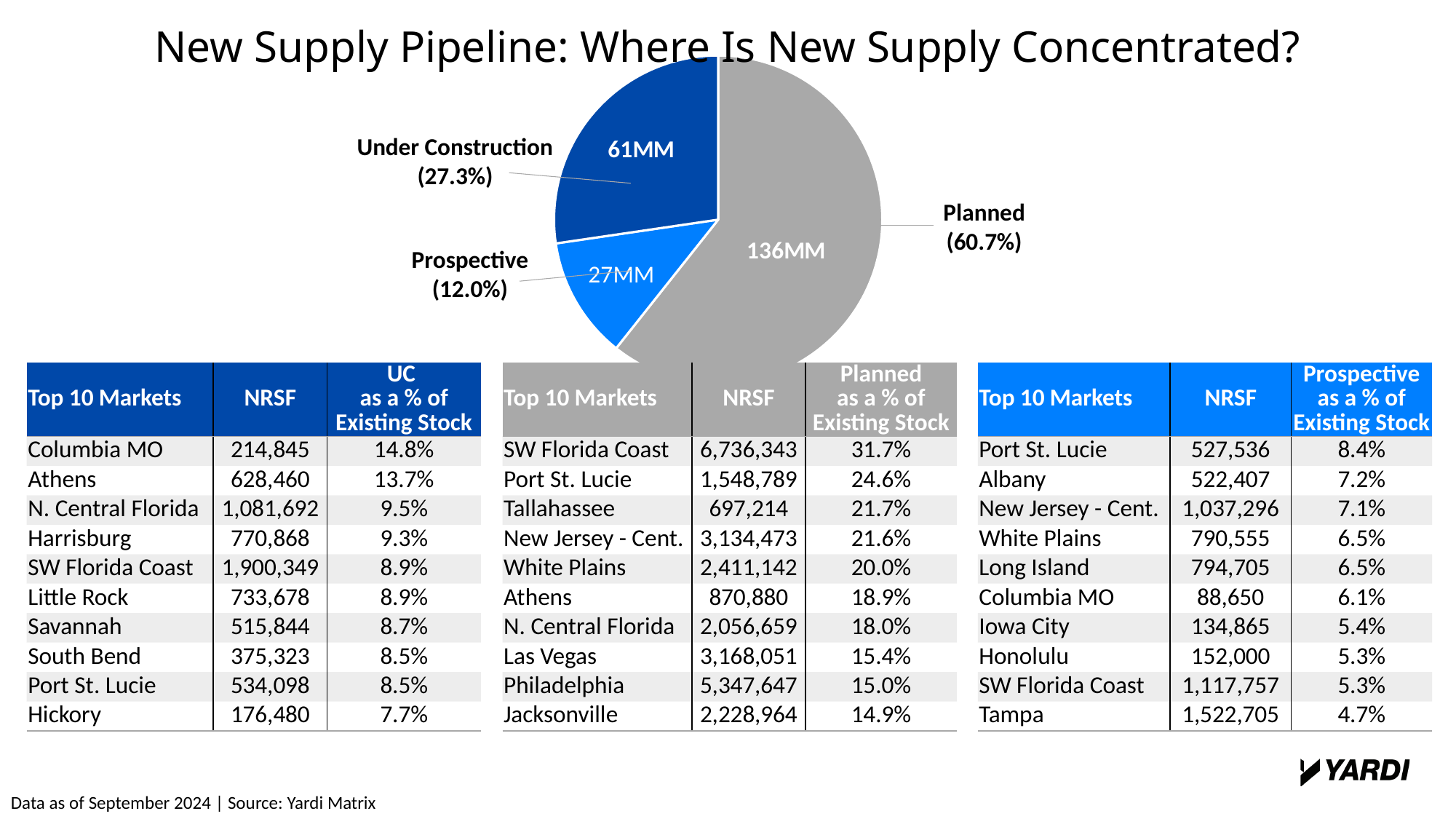
What kind of chart is shown on the slide? pie chart What is the value shown for the Prospective slice of the pie chart? 27MM What share of the pie does the Planned slice represent? 60.7% What share of the pie does the Under Construction slice represent? 27.3% What is the difference in MM between the Planned slice and the Under Construction slice? 75MM What share of the pie does the Prospective slice represent? 12.0% What is the value shown for the Under Construction slice of the pie chart? 61MM Which is larger in the pie chart, Under Construction or Prospective? Under Construction Which slice of the pie chart is the smallest? Prospective How many slices does the pie chart have? 3 What is the value shown for the Planned slice of the pie chart? 136MM Which slice of the pie chart is the largest? Planned